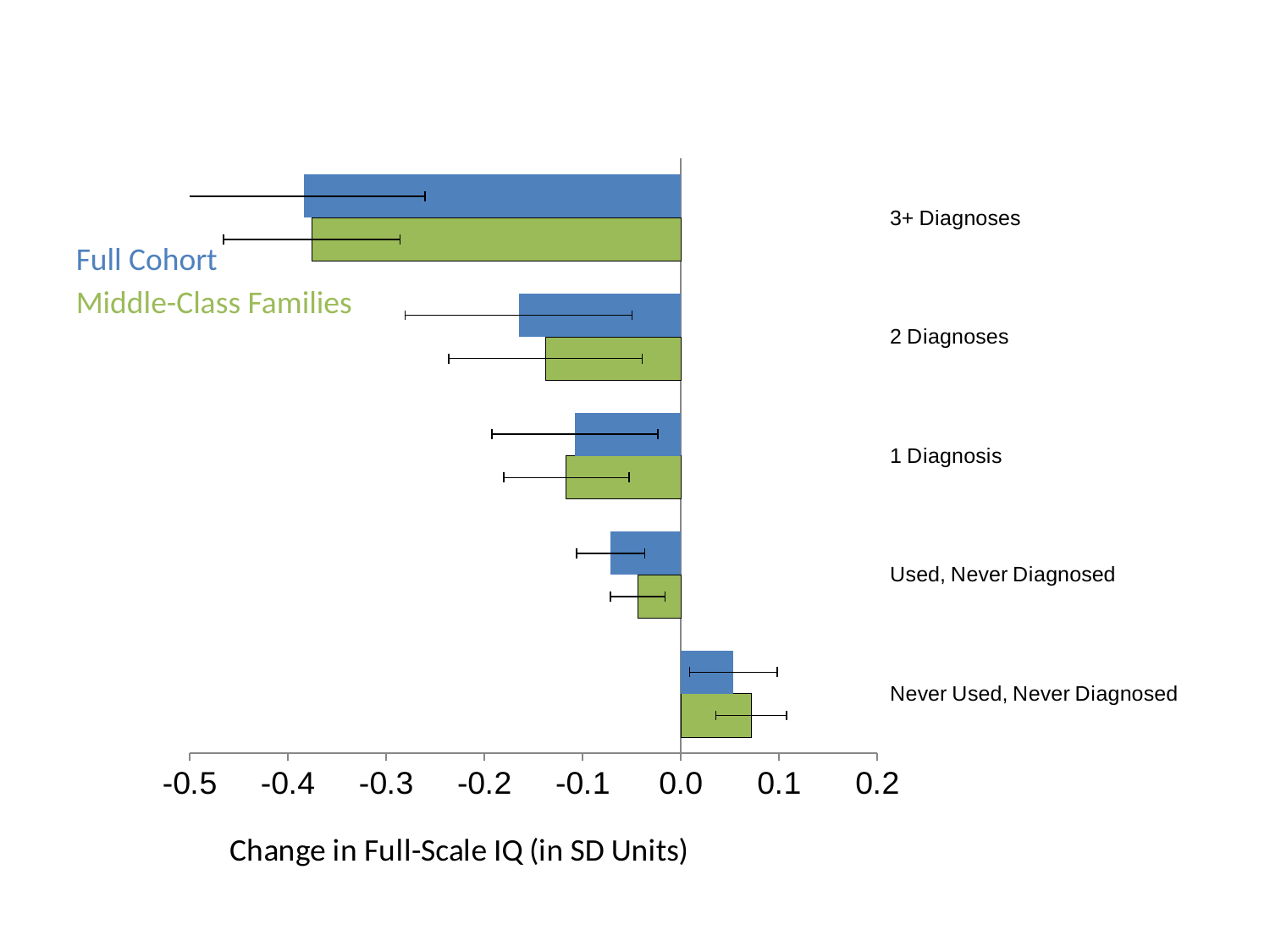
Which colour represents the Full Cohort series? blue How many categories are plotted on the chart? 5 For the 2 Diagnoses category, which series has the larger (less negative) value, Full Cohort or Middle-Class Families? Middle-Class Families Which category has the highest value for the Middle-Class Families series? Never Used, Never Diagnosed Which category has the lowest value for the Full Cohort series? 3+ Diagnoses What is the title of the horizontal axis? Change in Full-Scale IQ (in SD Units) What kind of chart is shown on the slide? bar chart Is the Middle-Class Families value for Used, Never Diagnosed greater or less than -0.1? greater How many series does the legend list? 2 Is the Full Cohort value for 3+ Diagnoses greater or less than -0.3? less Is the Full Cohort value for Never Used, Never Diagnosed greater or less than 0.0? greater